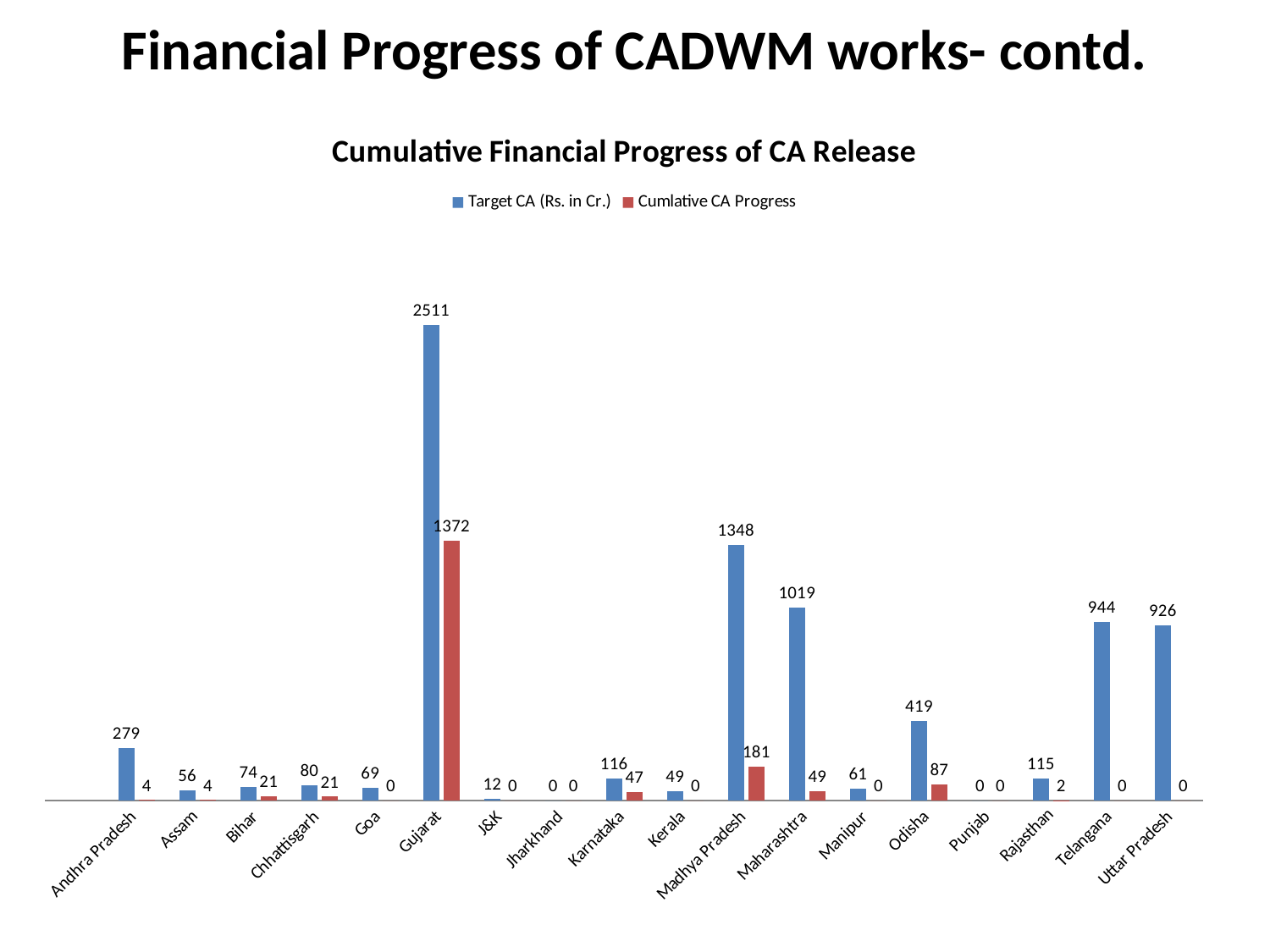
What is the Target CA (Rs. in Cr.) value for Odisha? 419 Which has a larger Cumlative CA Progress value, Karnataka or Odisha? Odisha What is the difference between the Target CA (Rs. in Cr.) and Cumlative CA Progress values for Gujarat? 1139 What type of chart is shown on the slide? Bar chart How many series does the legend list? 2 Which has a larger Target CA (Rs. in Cr.) value, Telangana or Uttar Pradesh? Telangana Which state has the highest Cumlative CA Progress value? Gujarat Which state has the highest Target CA (Rs. in Cr.) value? Gujarat How many states are shown on the x axis of the chart? 18 What is the Cumlative CA Progress value for Madhya Pradesh? 181 What is the difference between the Target CA (Rs. in Cr.) values for Madhya Pradesh and Maharashtra? 329 What is the Target CA (Rs. in Cr.) value for Gujarat? 2511